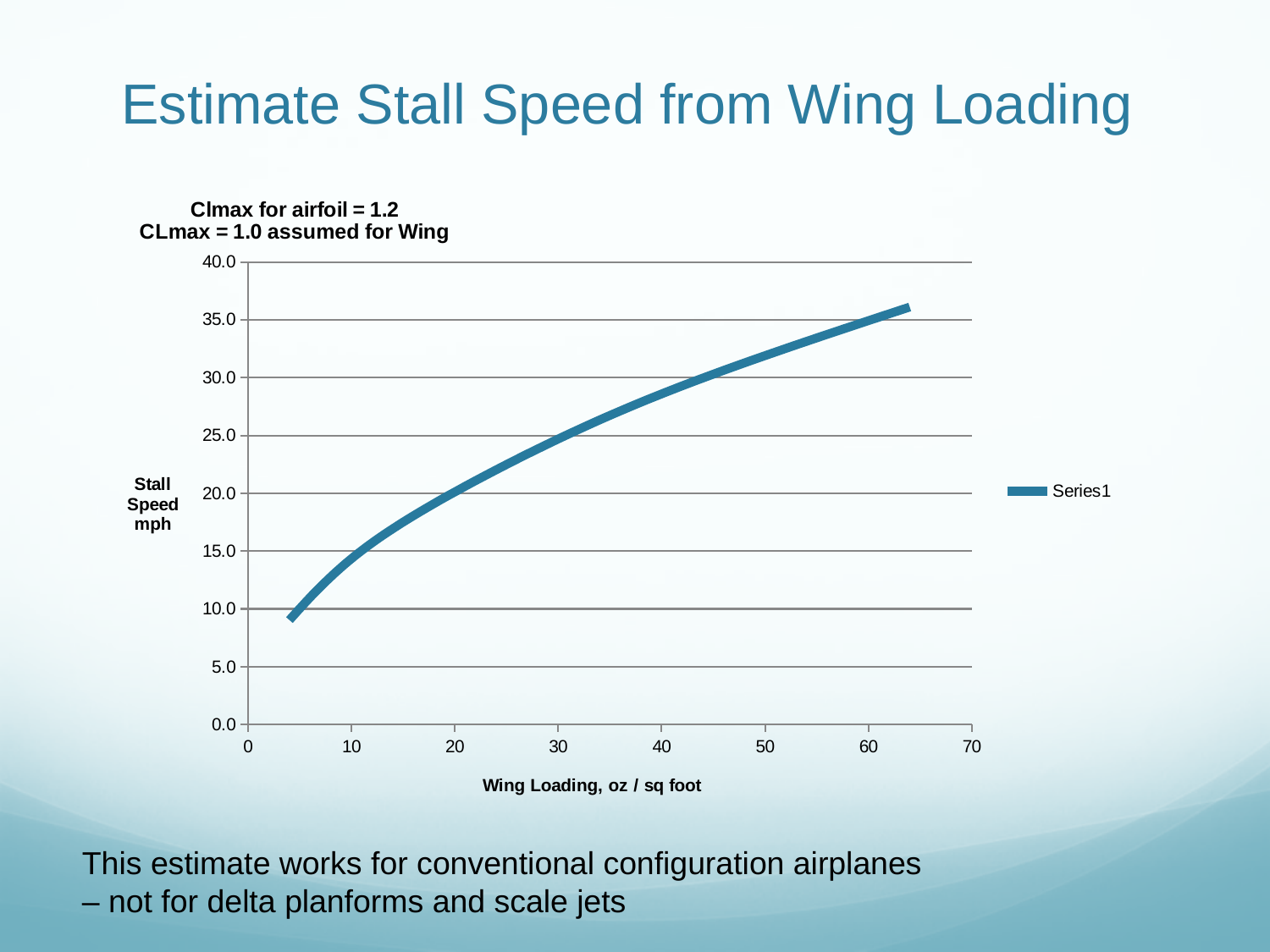
Is the stall speed at a wing loading of 30 greater or less than 20.0 mph? greater What is the label of the x axis? Wing Loading, oz / sq foot Is the stall speed at a wing loading of 50 greater or less than 30.0 mph? greater How many series does the legend list? 1 Is the stall speed at a wing loading of 20 greater or less than 15.0 mph? greater What kind of chart is shown on the slide? line chart What is the title shown above the chart? Clmax for airfoil = 1.2 CLmax = 1.0 assumed for Wing Does the stall speed rise or fall as wing loading increases along the x axis? rise